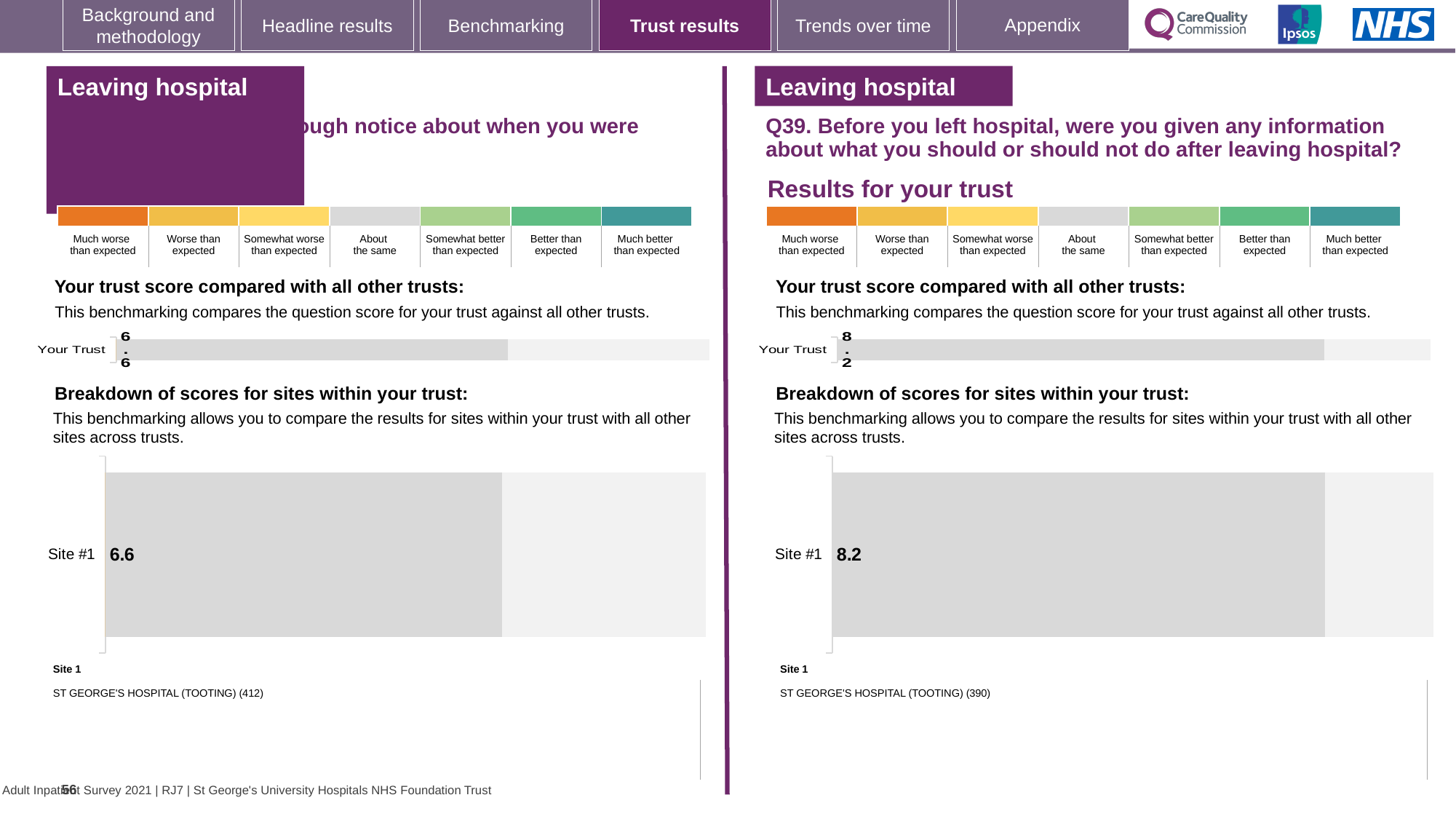
What is the difference between the Your Trust score on the right-hand side (8.2) and the Your Trust score on the left-hand side (6.6)? 1.6 In the left-hand 'Breakdown of scores for sites within your trust' chart, what is the score for Site #1? 6.6 In the right-hand 'Breakdown of scores for sites within your trust' chart, what is the score for Site #1? 8.2 How many sites are shown in the right-hand 'Breakdown of scores for sites within your trust' chart? 1 What kind of chart is used to show the Site #1 score on the right-hand side of the slide? Bar chart On the left-hand side of the slide, what is the score shown for Your Trust? 6.6 Which site is listed as Site 1 beneath the right-hand breakdown chart? ST GEORGE'S HOSPITAL (TOOTING) (390) On the right-hand side of the slide (Q39), what is the score shown for Your Trust? 8.2 How many sites are shown in the left-hand 'Breakdown of scores for sites within your trust' chart? 1 What kind of chart is used to show the Your Trust score on the left-hand side of the slide? Bar chart How many rating categories are shown in the colour scale above the right-hand 'Your trust score compared with all other trusts' section? 7 Which is larger: the Site #1 score in the left-hand breakdown chart or the Site #1 score in the right-hand breakdown chart? The right-hand chart (8.2)